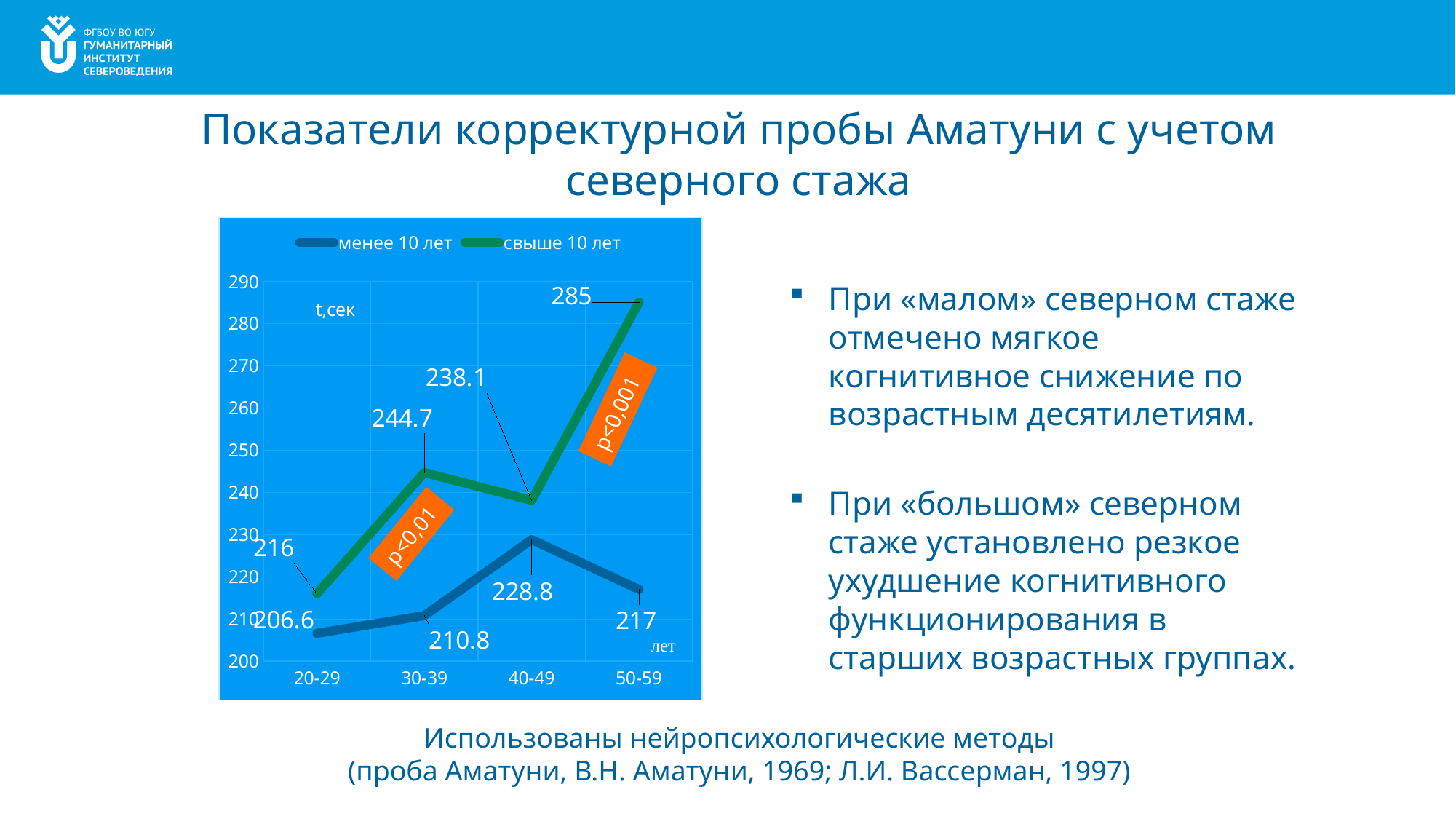
Which series has the larger value in the 40-49 age group, 'менее 10 лет' or 'свыше 10 лет'? свыше 10 лет What type of chart is shown on the slide? line chart What is the difference between the 'свыше 10 лет' and 'менее 10 лет' values in the 50-59 age group? 68 What is the value for the 'менее 10 лет' series in the 40-49 age group? 228.8 What is the value for the 'свыше 10 лет' series in the 30-39 age group? 244.7 In which age group does the 'свыше 10 лет' series reach its highest value? 50-59 In which age group does the 'менее 10 лет' series have its lowest value? 20-29 How many age groups are shown on the x axis of the chart? 4 How many series does the chart legend list? 2 What unit label is shown on the vertical axis of the chart? t,сек What is the value for the 'менее 10 лет' series in the 20-29 age group? 206.6 What is the value for the 'свыше 10 лет' series in the 50-59 age group? 285